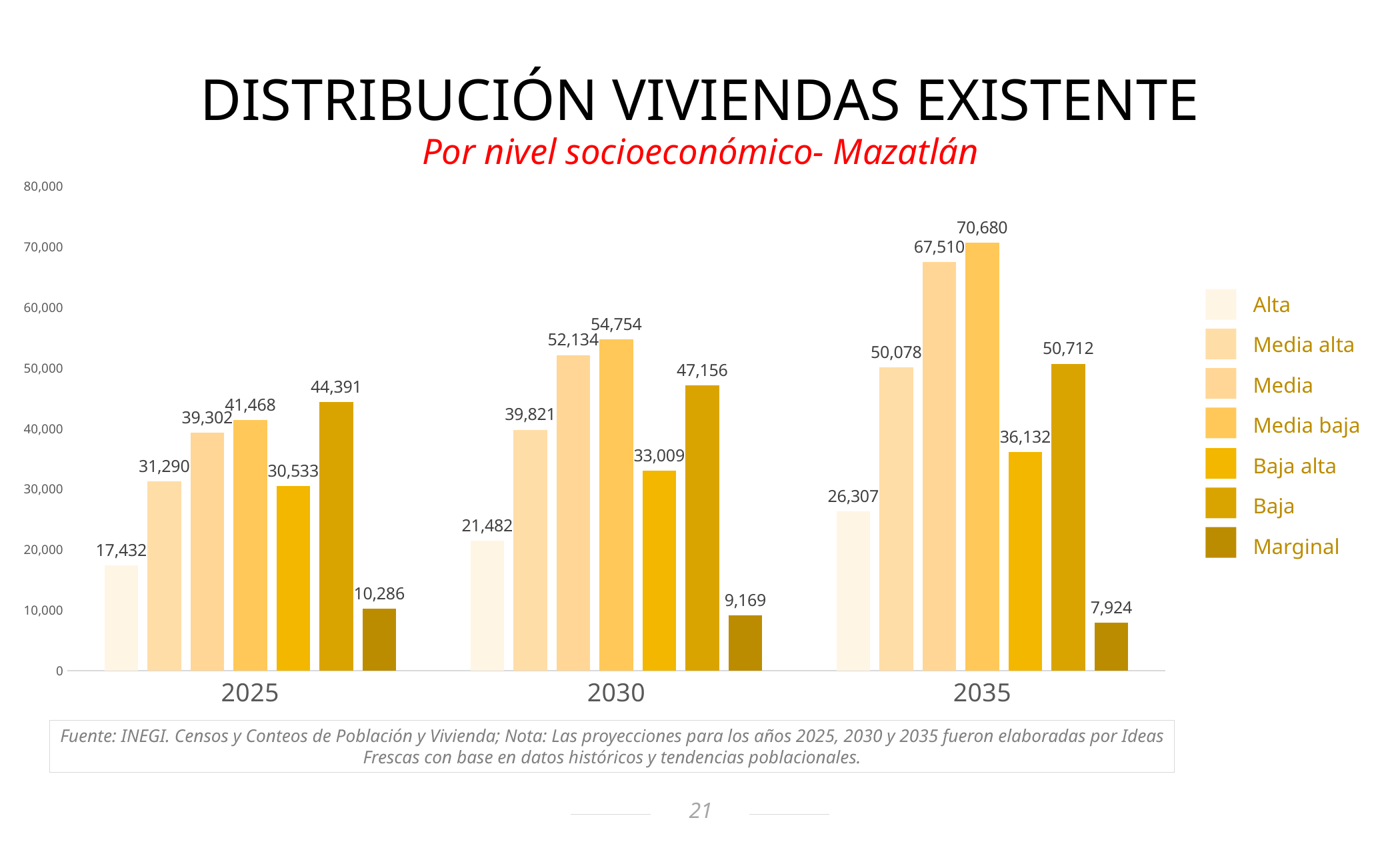
How many years are shown on the x axis? 3 Which socioeconomic level has the lowest value in 2035? Marginal What is the difference between the Alta value in 2030 and the Alta value in 2025? 4,050 What is the value for Marginal in 2025? 10,286 What is the difference between Media baja and Media in 2035? 3,170 What is the value for Baja alta in 2030? 33,009 What is the value for Media baja in 2035? 70,680 In 2025, which is larger: Baja or Media baja? Baja What kind of chart is shown on the slide? bar chart Which socioeconomic level has the highest value in 2030? Media baja How many series does the legend list? 7 Do the Marginal values rise or fall from 2025 to 2035? fall